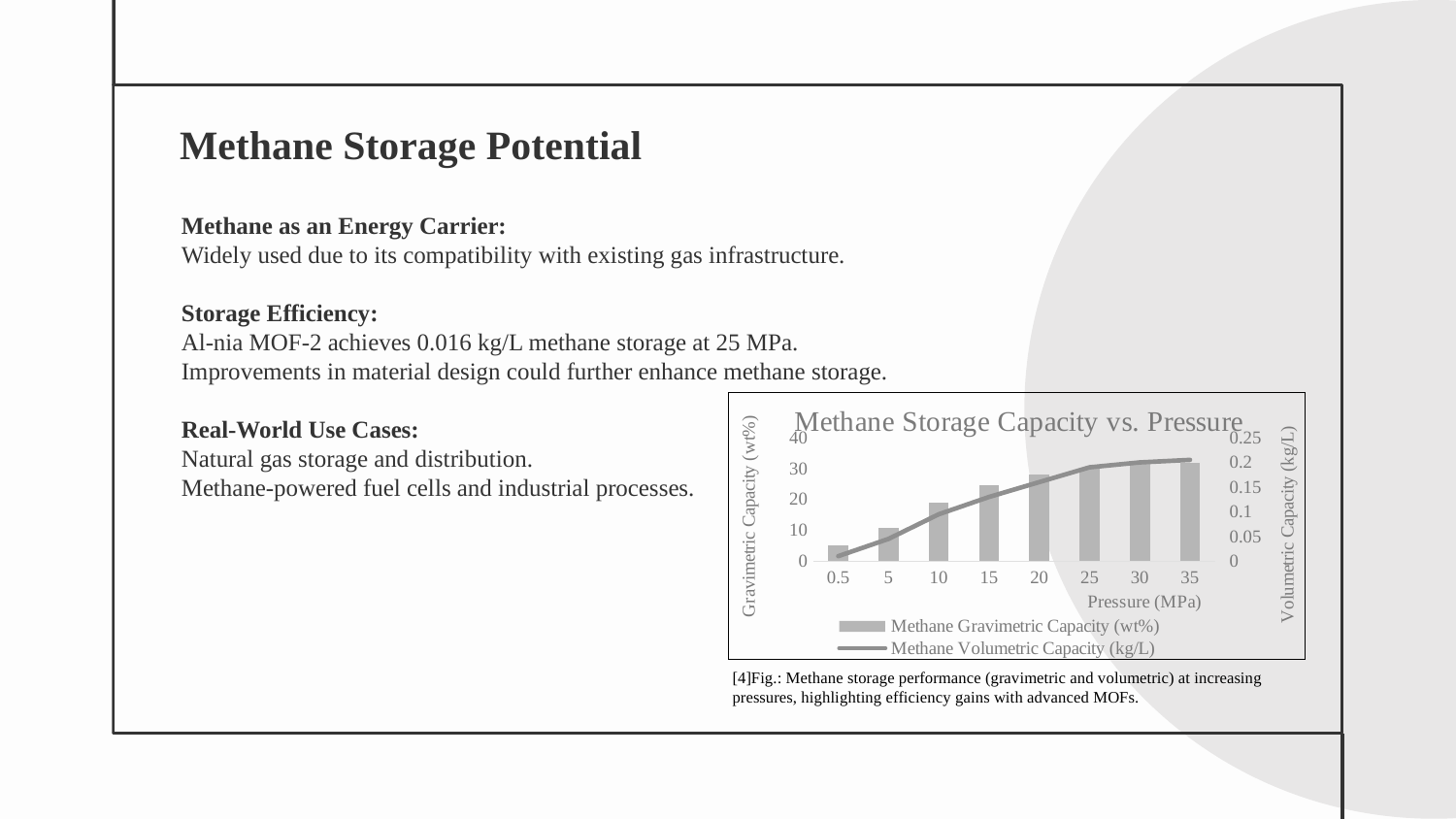
Does the Methane Volumetric Capacity (kg/L) line rise or fall as pressure increases along the x axis? rise How many series does the chart legend list? 2 Is the Methane Volumetric Capacity (kg/L) at 5 MPa greater or less than 0.1? less Is the Methane Volumetric Capacity (kg/L) at 35 MPa greater or less than 0.15? greater What kind of chart is used to show Methane Gravimetric Capacity (wt%)? bar chart At which pressure is the Methane Gravimetric Capacity (wt%) bar the lowest? 0.5 Is the Methane Gravimetric Capacity (wt%) at 0.5 MPa greater or less than 10? less How many pressure values are plotted along the x axis of the chart? 8 Which has the larger Methane Gravimetric Capacity (wt%): 5 MPa or 20 MPa? 20 MPa What is the title of the chart on the slide? Methane Storage Capacity vs. Pressure What is the label of the x axis of the chart? Pressure (MPa)